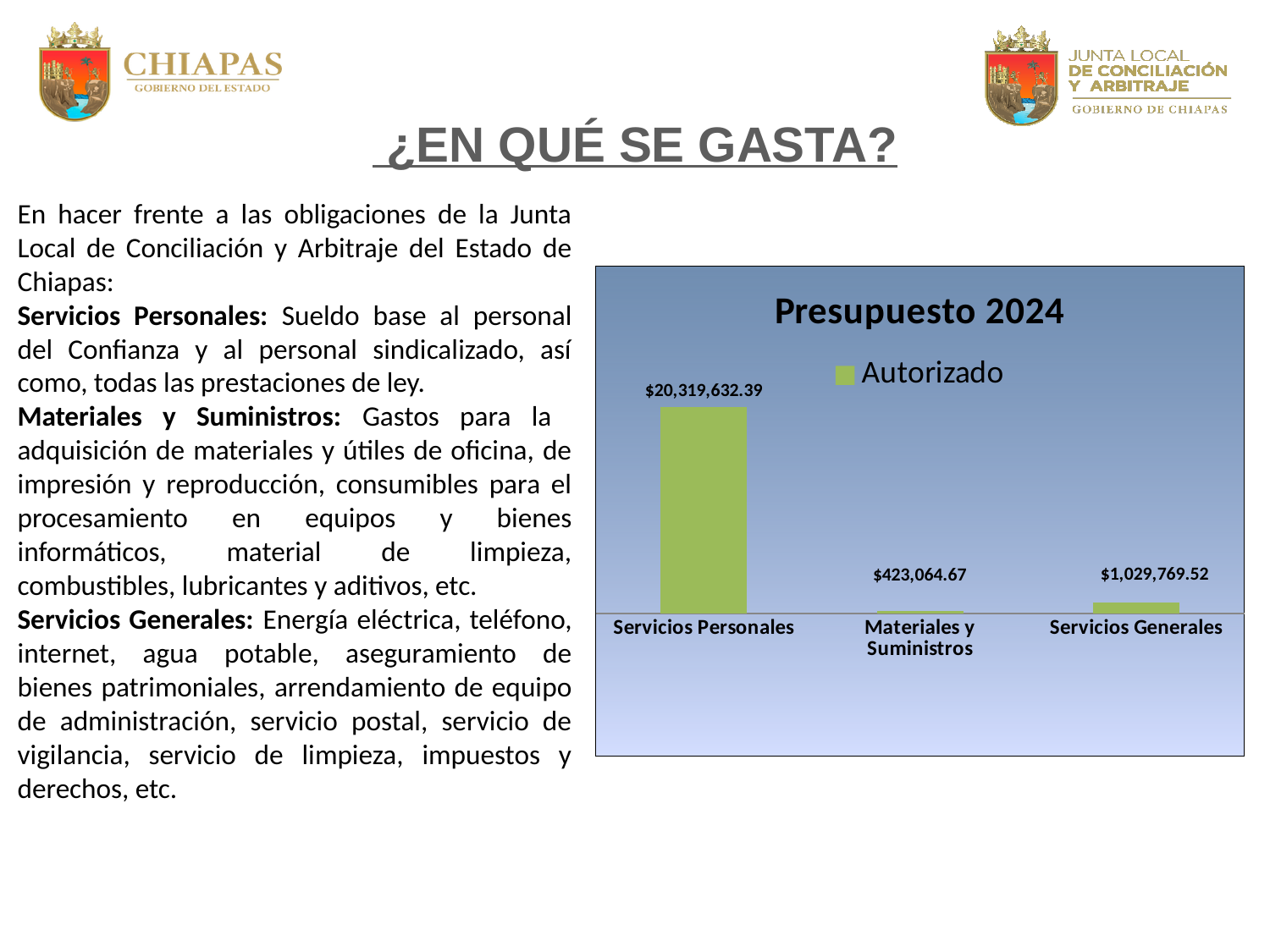
What is the difference between the values for Servicios Generales and Materiales y Suministros? $606,704.85 How many series does the legend of the Presupuesto 2024 chart list? 1 What kind of chart is shown on the slide? Bar chart What is the value for Servicios Personales in the Presupuesto 2024 chart? $20,319,632.39 What is the difference between the values for Servicios Personales and Servicios Generales? $19,289,862.87 Which category has the highest value in the Presupuesto 2024 chart? Servicios Personales What is the name of the series shown in the chart's legend? Autorizado What is the value for Servicios Generales in the Presupuesto 2024 chart? $1,029,769.52 What is the value for Materiales y Suministros in the Presupuesto 2024 chart? $423,064.67 Which is larger, the value for Servicios Generales or the value for Materiales y Suministros? Servicios Generales Which category has the lowest value in the Presupuesto 2024 chart? Materiales y Suministros How many categories are shown in the Presupuesto 2024 chart? 3